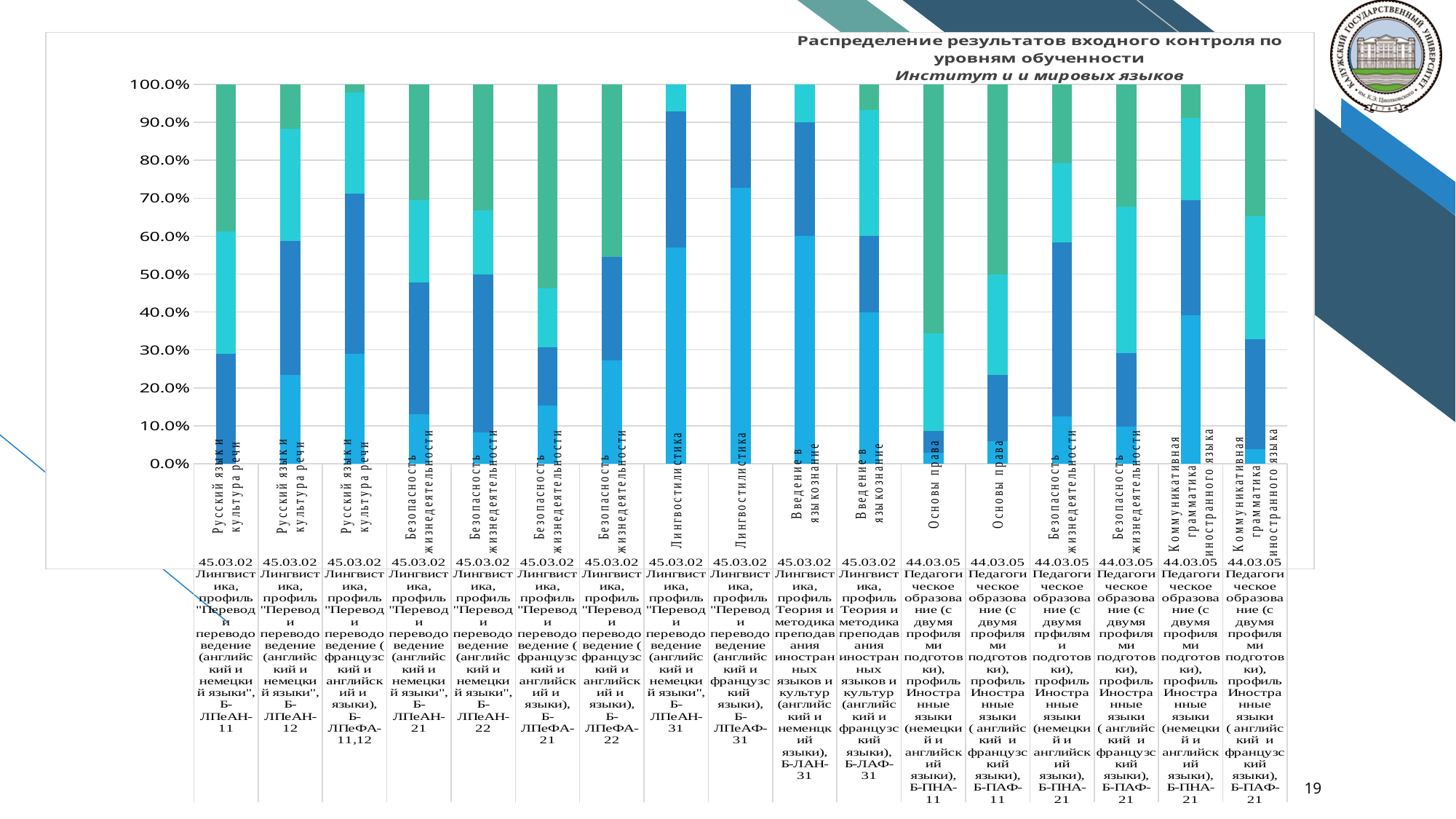
How many bars in the chart are labelled Безопасность жизнедеятельности? 6 What is the highest value shown on the vertical axis? 100.0% Is the bottom (light blue) segment of the bar for Русский язык и культура речи, Б-ЛПеАН-12 greater or less than 30%? less Is the bottom (light blue) segment of the bar for Коммуникативная грамматика иностранного языка, Б-ПАФ-21 greater or less than 10%? less What kind of chart is shown on the slide? bar chart Is the bottom (light blue) segment of the bar for Лингвостилистика, Б-ЛПеАФ-31 greater or less than 60%? greater What is the title of the chart? Распределение результатов входного контроля по уровням обученности Which bar has the larger bottom (light blue) segment: Лингвостилистика, Б-ЛПеАН-31 or Русский язык и культура речи, Б-ЛПеАН-11? Лингвостилистика, Б-ЛПеАН-31 How many bars (programme groups) are plotted in the chart? 17